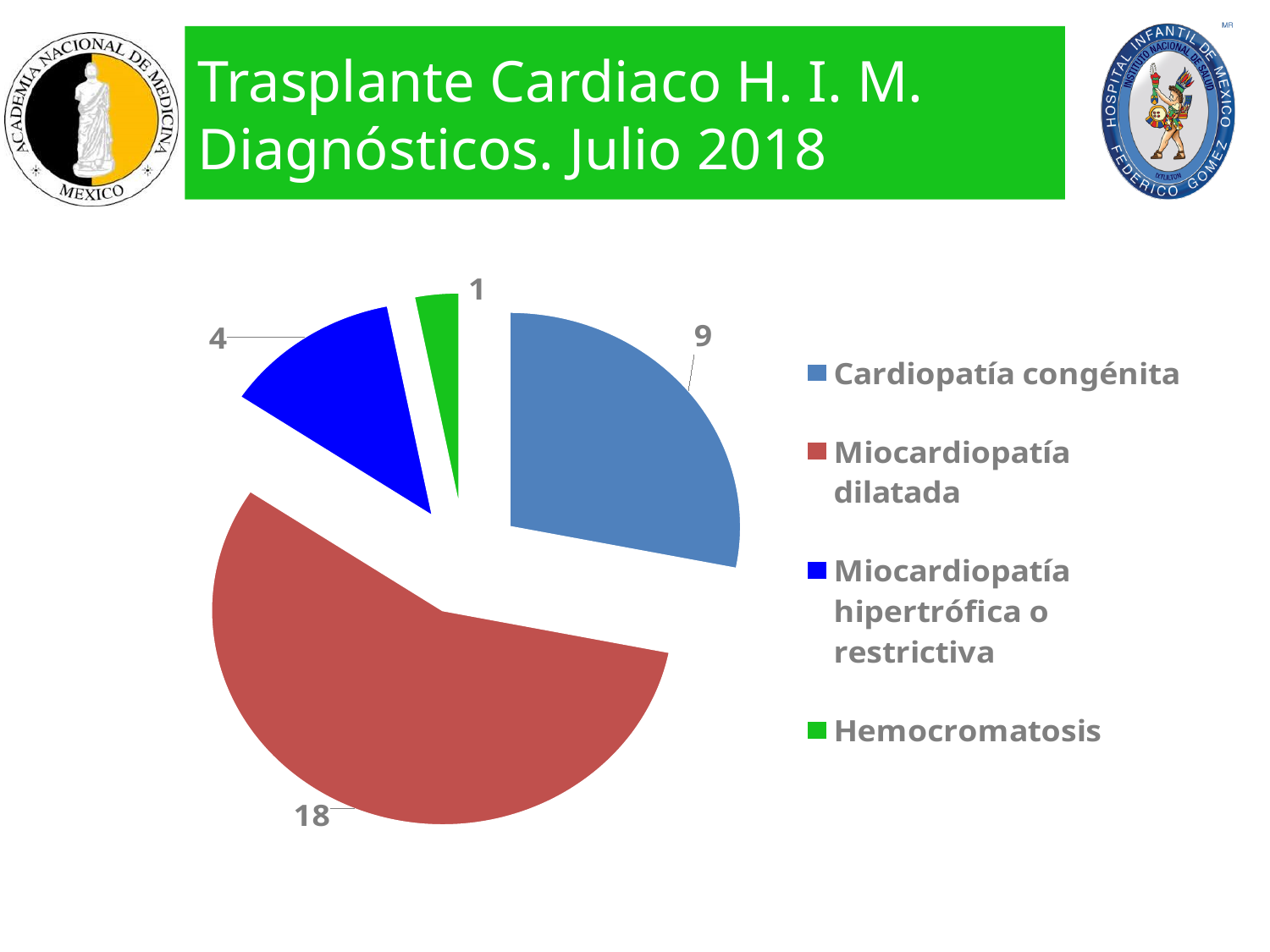
What is the value for Hemocromatosis? 1 What colour is the Hemocromatosis slice? Green What is the value for Cardiopatía congénita? 9 Which diagnosis has the smallest slice of the pie? Hemocromatosis What kind of chart is shown on the slide? Pie chart What is the total of all the slices in the pie chart? 32 How many slices does the pie chart have? 4 What is the value for Miocardiopatía hipertrófica o restrictiva? 4 What is the value for Miocardiopatía dilatada? 18 Which diagnosis has the largest slice of the pie? Miocardiopatía dilatada Which is larger, the value for Cardiopatía congénita or the value for Miocardiopatía hipertrófica o restrictiva? Cardiopatía congénita What is the difference between the values for Miocardiopatía dilatada and Cardiopatía congénita? 9